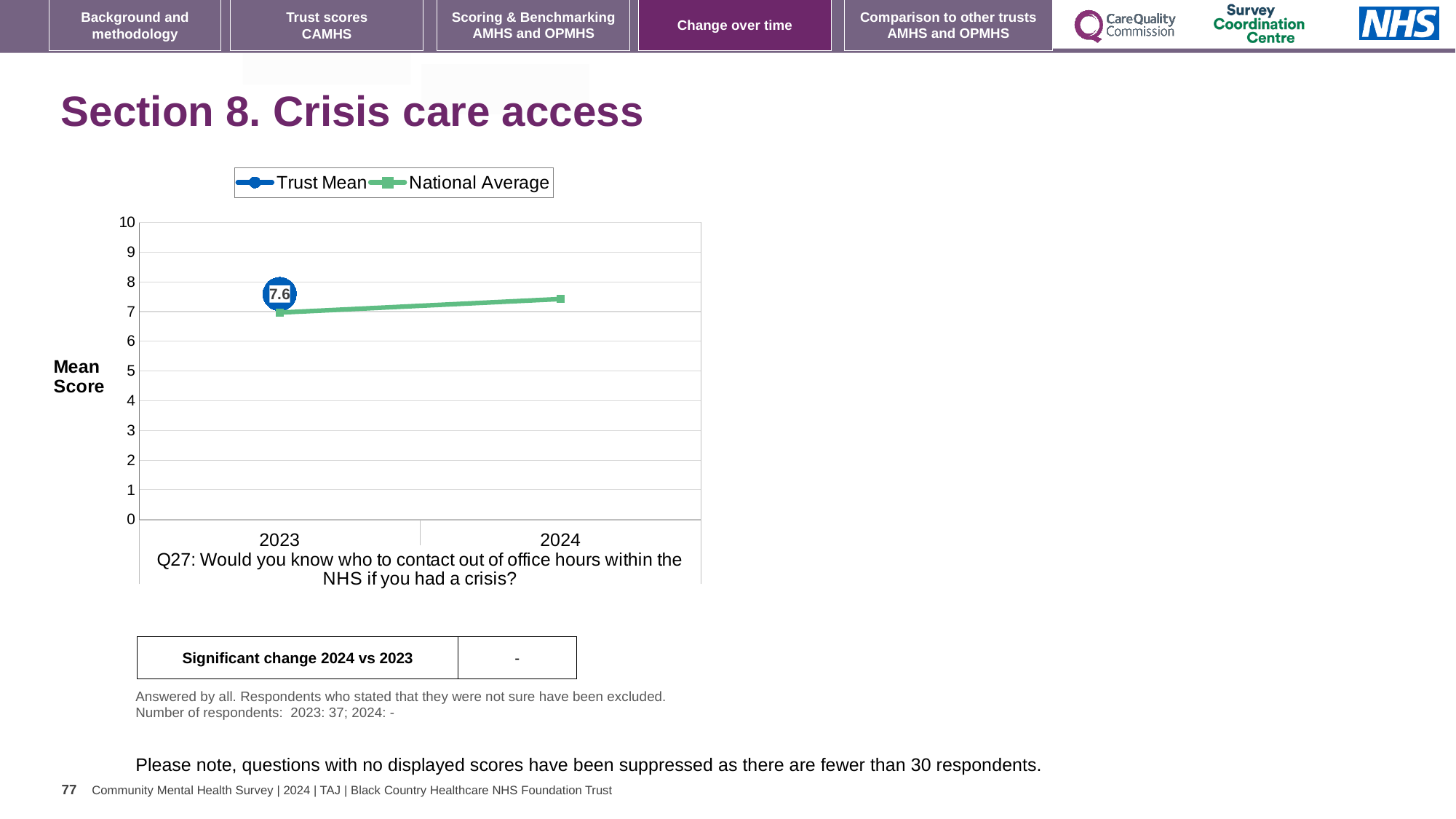
What is the Trust Mean value for 2023? 7.6 What type of chart is shown on the slide? line chart Is the National Average value for 2024 greater or less than 8? less Is the National Average value for 2024 greater or less than 7? greater What are the two series named in the legend? Trust Mean and National Average How many years are shown on the x axis? 2 In 2023, which is larger: the Trust Mean or the National Average? Trust Mean Is the Trust Mean value for 2023 greater or less than 7? greater How many series does the legend list? 2 What is the label on the y axis of the chart? Mean Score Does the National Average rise or fall from 2023 to 2024? rise